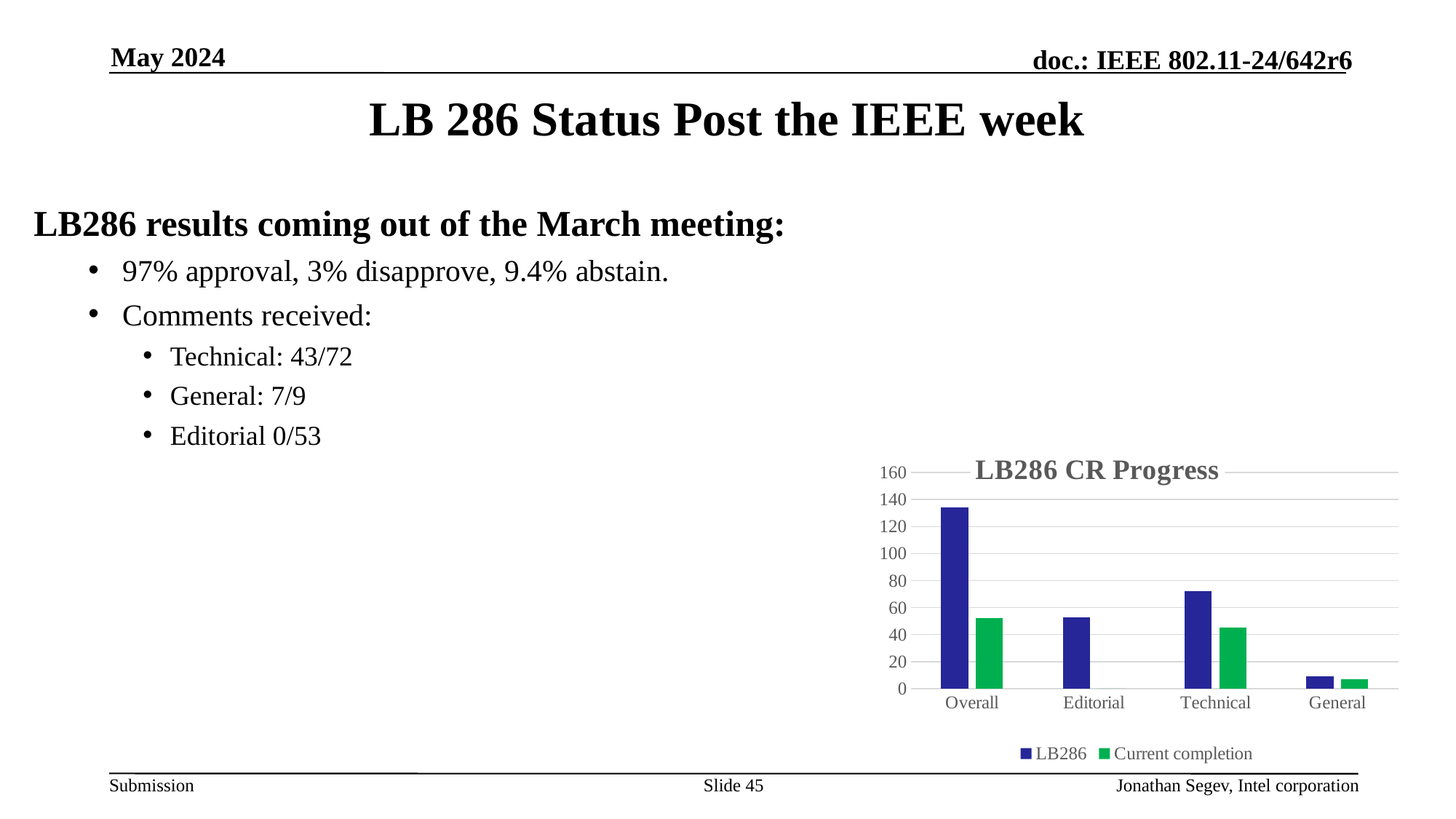
Which category has the highest Current completion value? Overall How many categories are shown on the x axis of the chart? 4 Is the Current completion value for Overall greater or less than 60? less Which category has the lowest LB286 value? General Is the LB286 value for Technical greater or less than 60? greater What is the title of the chart? LB286 CR Progress Which category has the highest LB286 value? Overall Which is larger, the LB286 value for Technical or the LB286 value for Editorial? Technical How many series does the chart legend list? 2 What type of chart is shown on the slide? bar chart Is the LB286 value for Overall greater or less than 120? greater What are the two series named in the chart legend? LB286 and Current completion